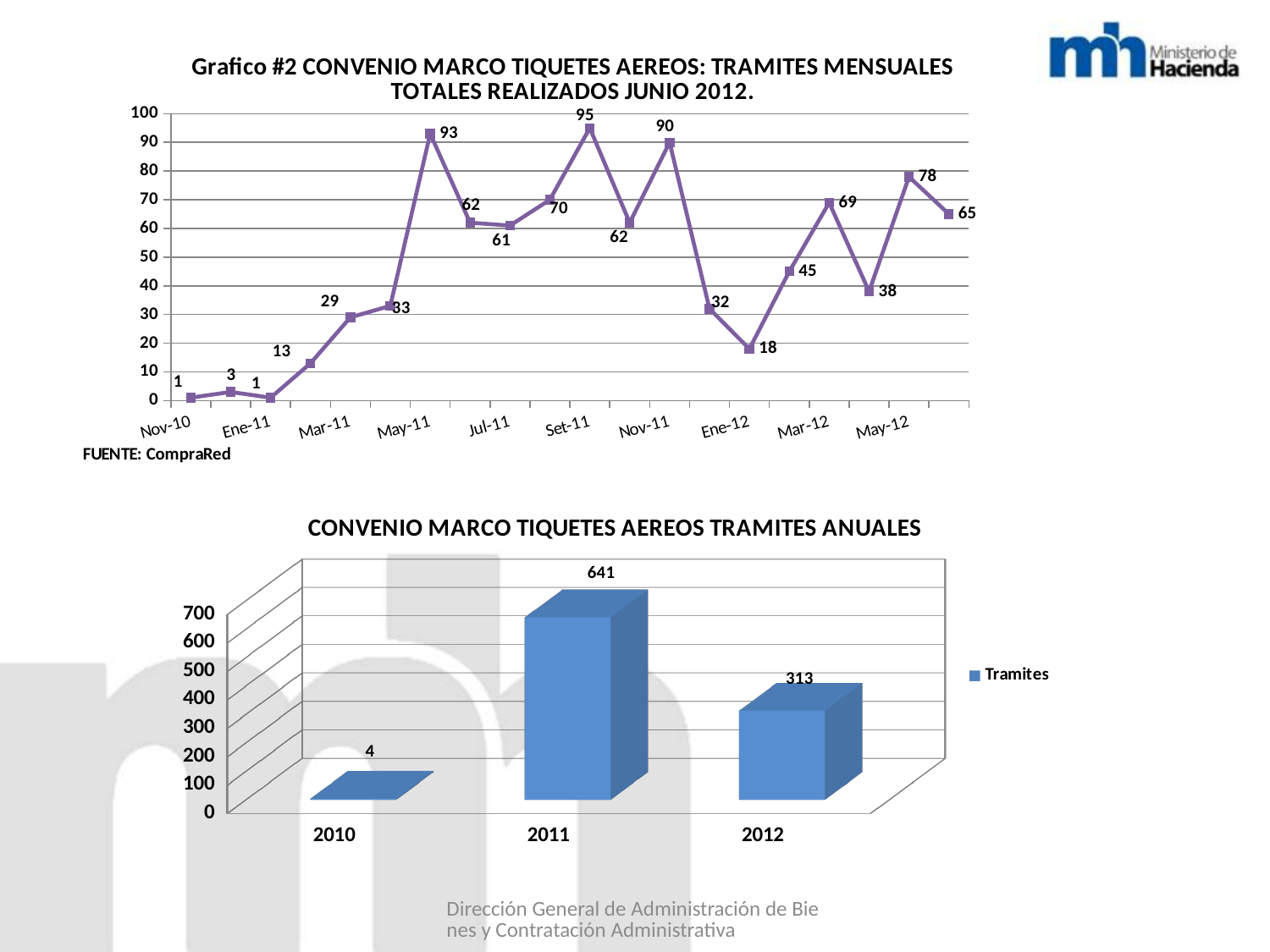
In the top chart (Grafico #2), which is larger, the value for Mar-11 or the value for May-12? May-12 In the top chart (Grafico #2), what is the value for Ene-12? 18 In the bottom chart (TRAMITES ANUALES), what is the value for 2011? 641 In the top chart (Grafico #2), what is the value for Set-11? 95 In the top chart (Grafico #2), which labeled month has the highest value? Set-11 How many bars are in the bottom chart (TRAMITES ANUALES)? 3 In the bottom chart (TRAMITES ANUALES), what is the difference between the values for 2011 and 2012? 328 What kind of chart is the top chart (Grafico #2)? line chart In the top chart (Grafico #2), what is the value for May-11? 93 In the bottom chart (TRAMITES ANUALES), which year has the lowest value? 2010 What series name does the legend of the bottom chart (TRAMITES ANUALES) show? Tramites In the top chart (Grafico #2), what is the difference between the values for Nov-11 and Mar-12? 21